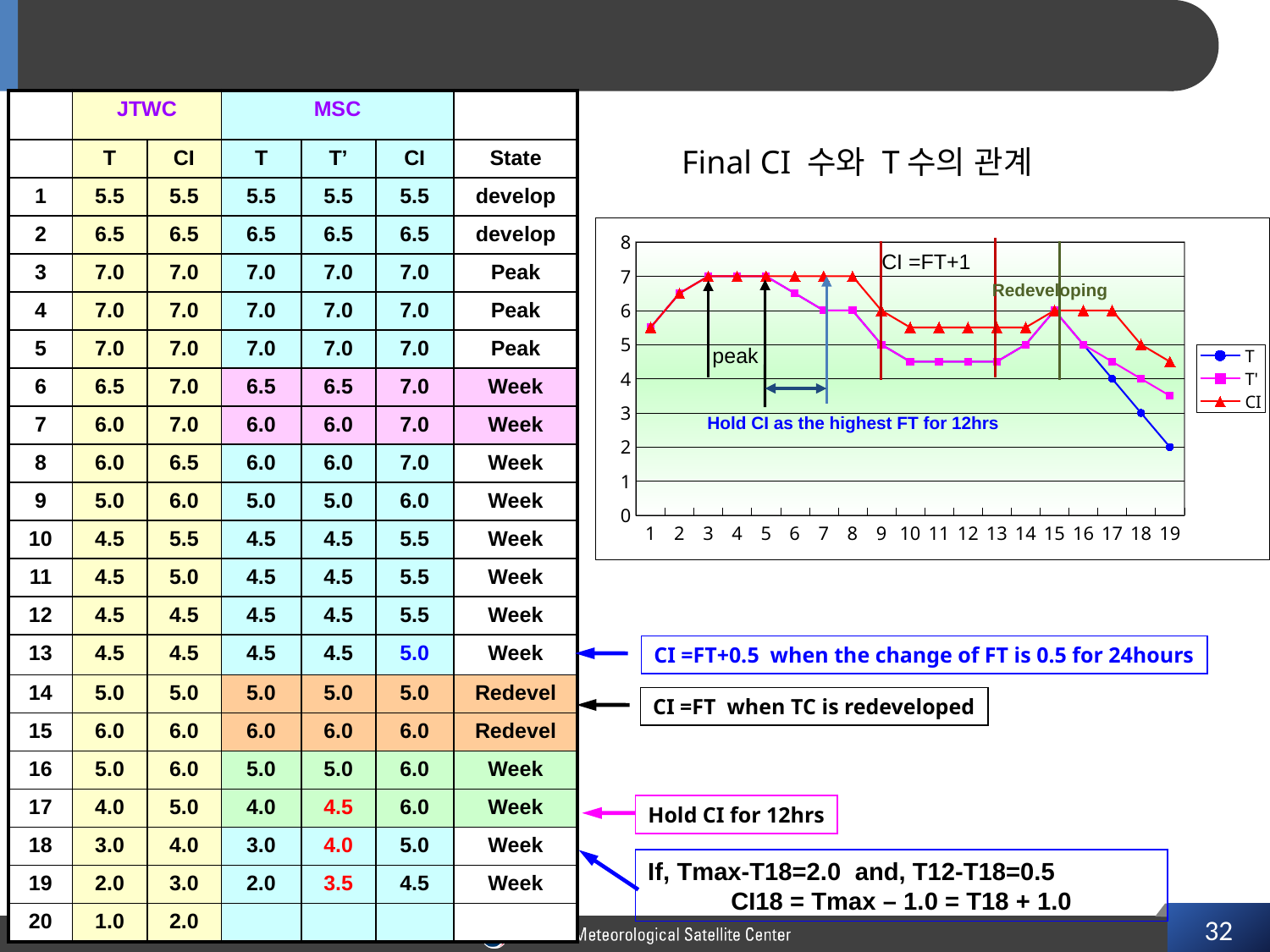
What is the value of the T series at x = 19? 2 How many points are there along the x axis of the chart? 19 What is the value of the T' series at x = 9? 5 How many series does the chart legend list? 3 What is the highest value reached by the CI series? 7 What is the difference between the T value at x = 15 and the T value at x = 19? 4 At which x value does the T series reach its lowest point? 19 Is the value of the T series at x = 18 greater or less than 4? less At x = 18, which series has the larger value, T or CI? CI What kind of chart is shown on the slide? line chart Does the T series rise or fall from x = 15 to x = 19? fall What is the value of the CI series at x = 3? 7